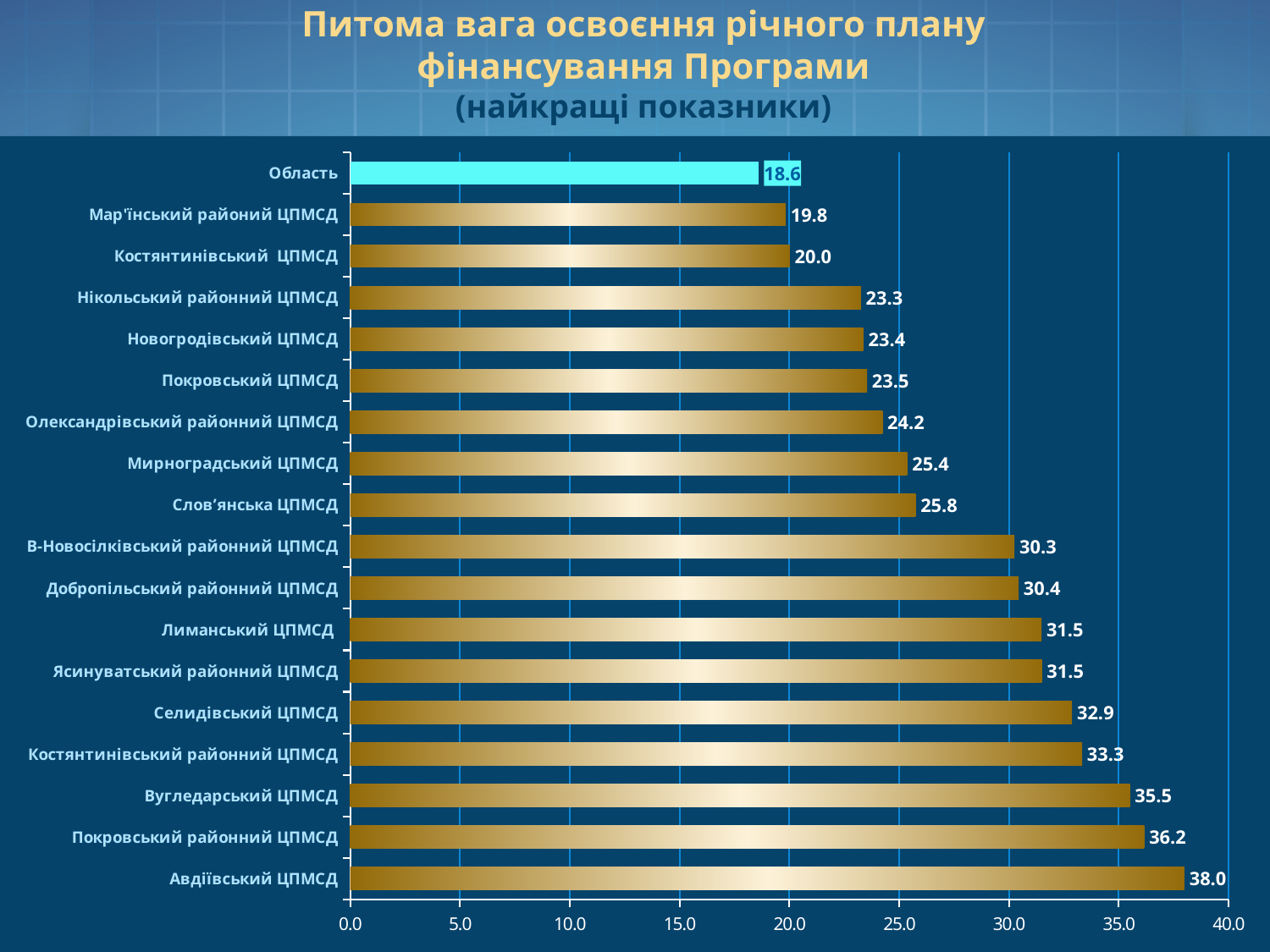
Which category has the highest value? Авдіївський ЦПМСД What is the value for Область? 18.6 What is the difference between the values for Авдіївський ЦПМСД and Область? 19.4 What is the value for Селидівський ЦПМСД? 32.9 What is the value for Авдіївський ЦПМСД? 38.0 What is the difference between the values for Покровський районний ЦПМСД and Вугледарський ЦПМСД? 0.7 What is the value for Мирноградський ЦПМСД? 25.4 How many categories are shown in the chart? 18 What kind of chart is shown on the slide? bar chart Is the value for Костянтинівський районний ЦПМСД greater or less than 30.0? greater Which category has the lowest value? Область Which is larger, the value for Лиманський ЦПМСД or the value for Слов’янська ЦПМСД? Лиманський ЦПМСД